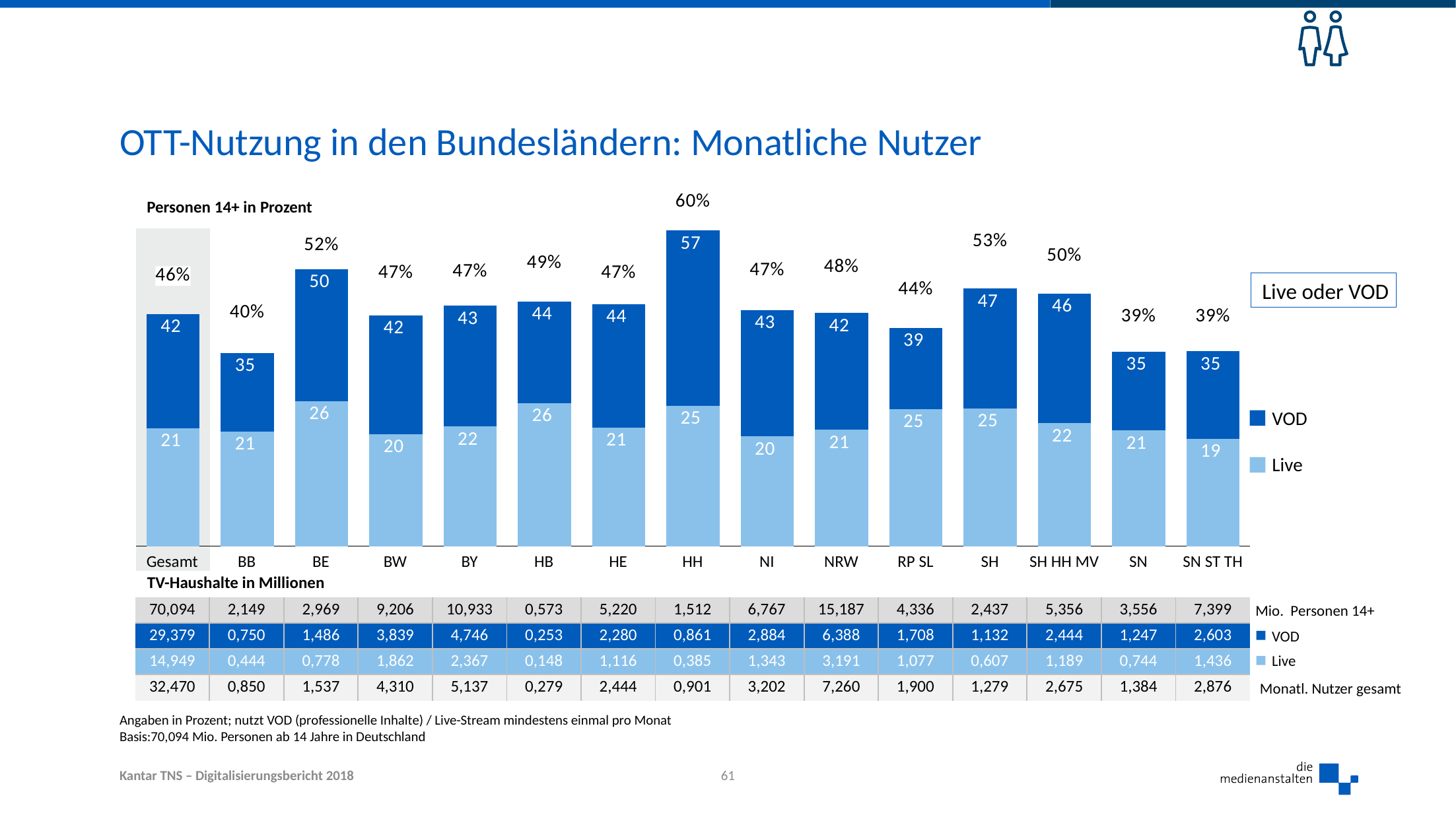
How many series does the chart legend list? 2 What is the Live value for Gesamt? 21 How many categories are shown on the x axis of the chart? 15 What kind of chart is shown on the slide? Stacked bar chart What is the VOD value for HH? 57 What is the 'Live oder VOD' percentage shown above the bar for SH? 53% What is the Live value for BE? 26 Which category has the highest VOD value? HH Which category has the lowest Live value? SN ST TH Which has the larger VOD value, BE or SH? BE What is the difference between the VOD value for HH and the VOD value for BB? 22 Which category has the highest 'Live oder VOD' percentage shown above the bars? HH